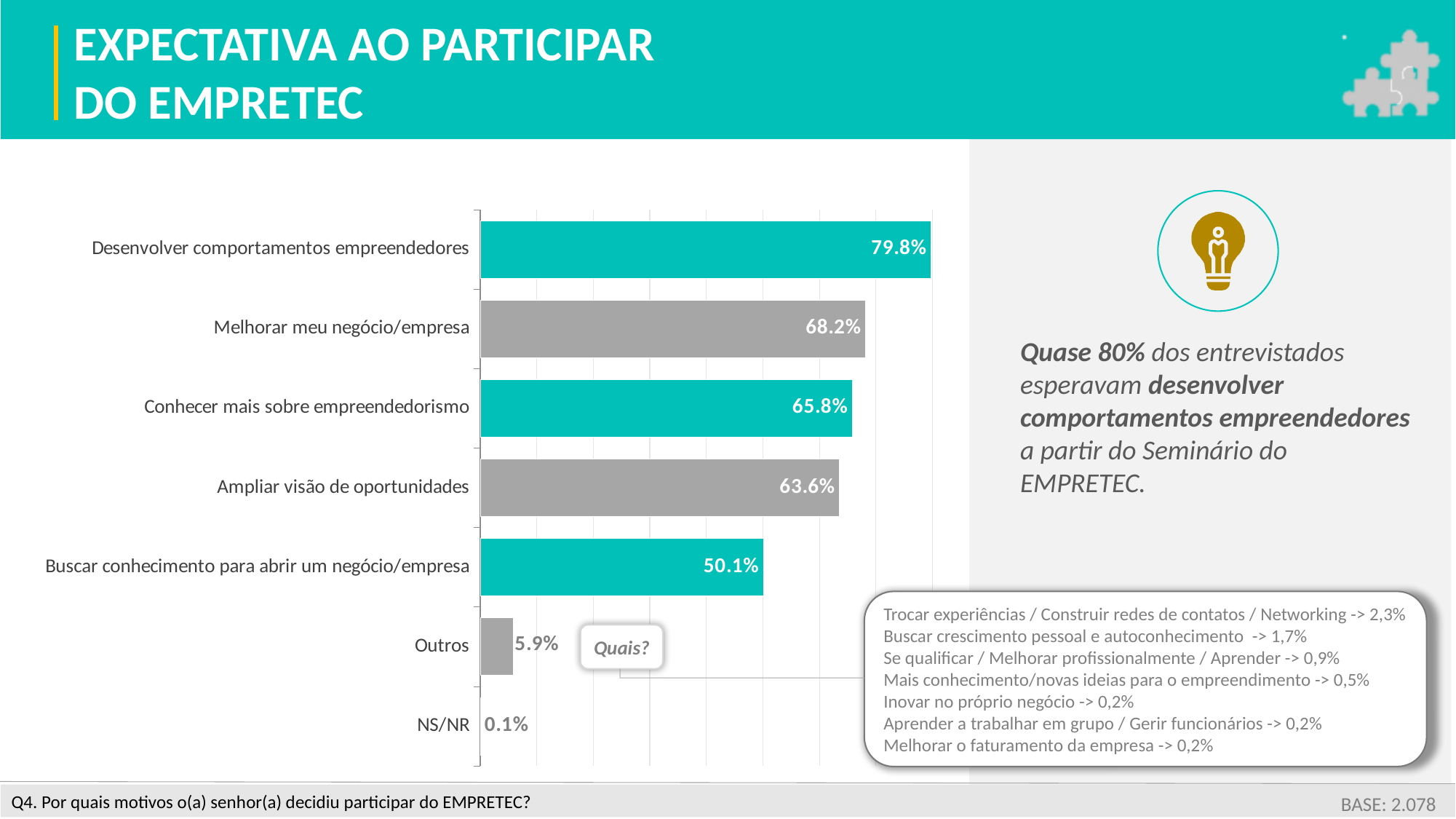
What is the base (number of respondents) shown on the slide? 2.078 What is the difference between "Ampliar visão de oportunidades" and "Buscar conhecimento para abrir um negócio/empresa"? 13.5% Which is larger: "Conhecer mais sobre empreendedorismo" or "Ampliar visão de oportunidades"? Conhecer mais sobre empreendedorismo What is the value for "Buscar conhecimento para abrir um negócio/empresa"? 50.1% How many categories are shown in the chart? 7 What is the value for "Melhorar meu negócio/empresa"? 68.2% What is the value for "Desenvolver comportamentos empreendedores"? 79.8% What kind of chart is shown on the slide? Bar chart What is the value for "Outros"? 5.9% What is the difference between "Desenvolver comportamentos empreendedores" and "Melhorar meu negócio/empresa"? 11.6% Which category has the highest value? Desenvolver comportamentos empreendedores Which category has the lowest value? NS/NR